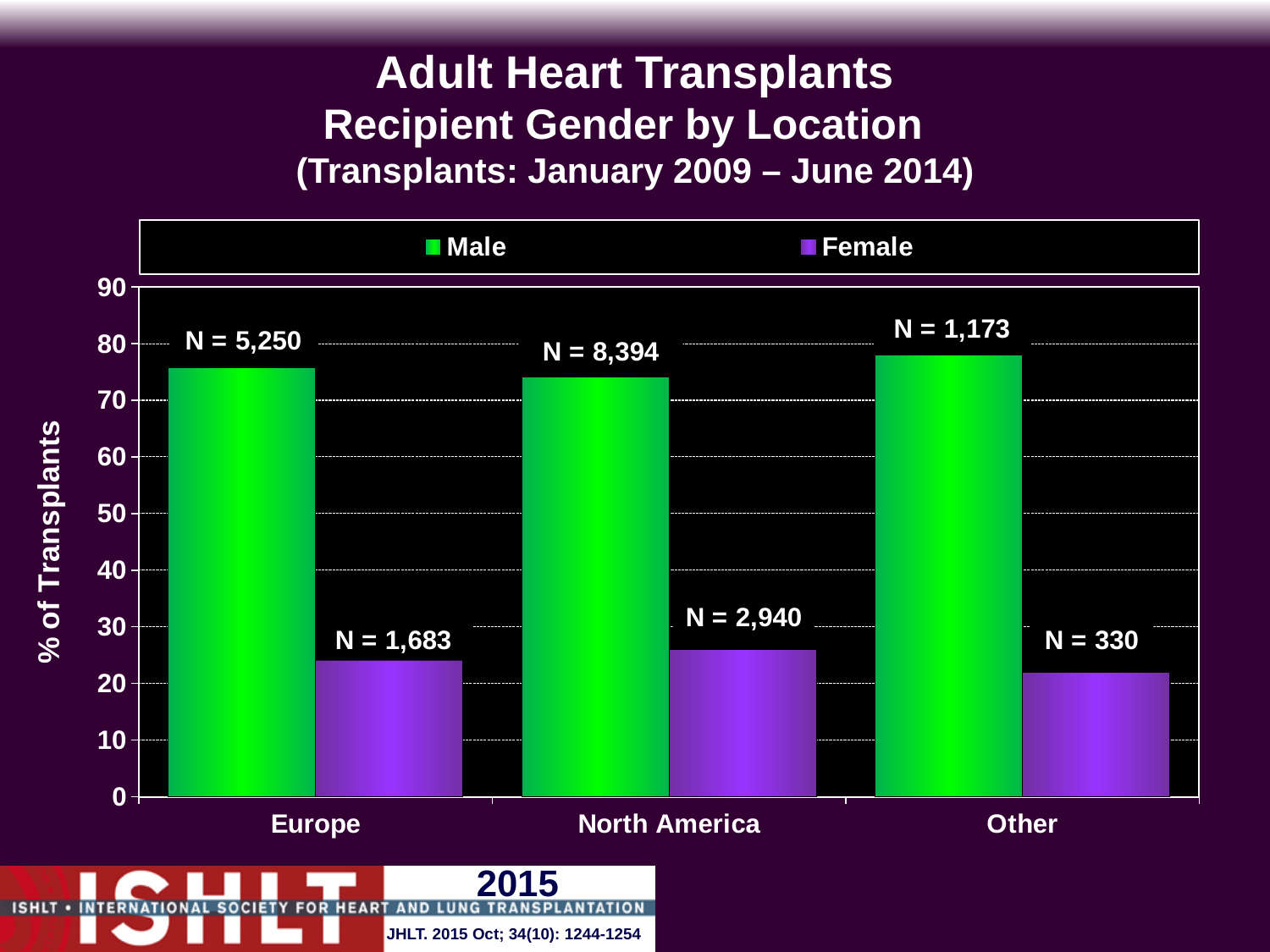
Is the Male value for North America greater or less than 70? greater What is the N value shown above the Female bar for North America? N = 2,940 How many series does the legend list? 2 Is the Female value for Other greater or less than 30? less What is the N value shown above the Male bar for Other? N = 1,173 Which is larger, the Male value for Other or the Male value for North America? Other What is the N value shown above the Male bar for Europe? N = 5,250 What is the N value shown above the Female bar for Europe? N = 1,683 How many location categories are shown on the x axis? 3 What is the N value shown above the Female bar for Other? N = 330 What kind of chart is shown on the slide? Bar chart Which is larger, the Female value for North America or the Female value for Other? North America